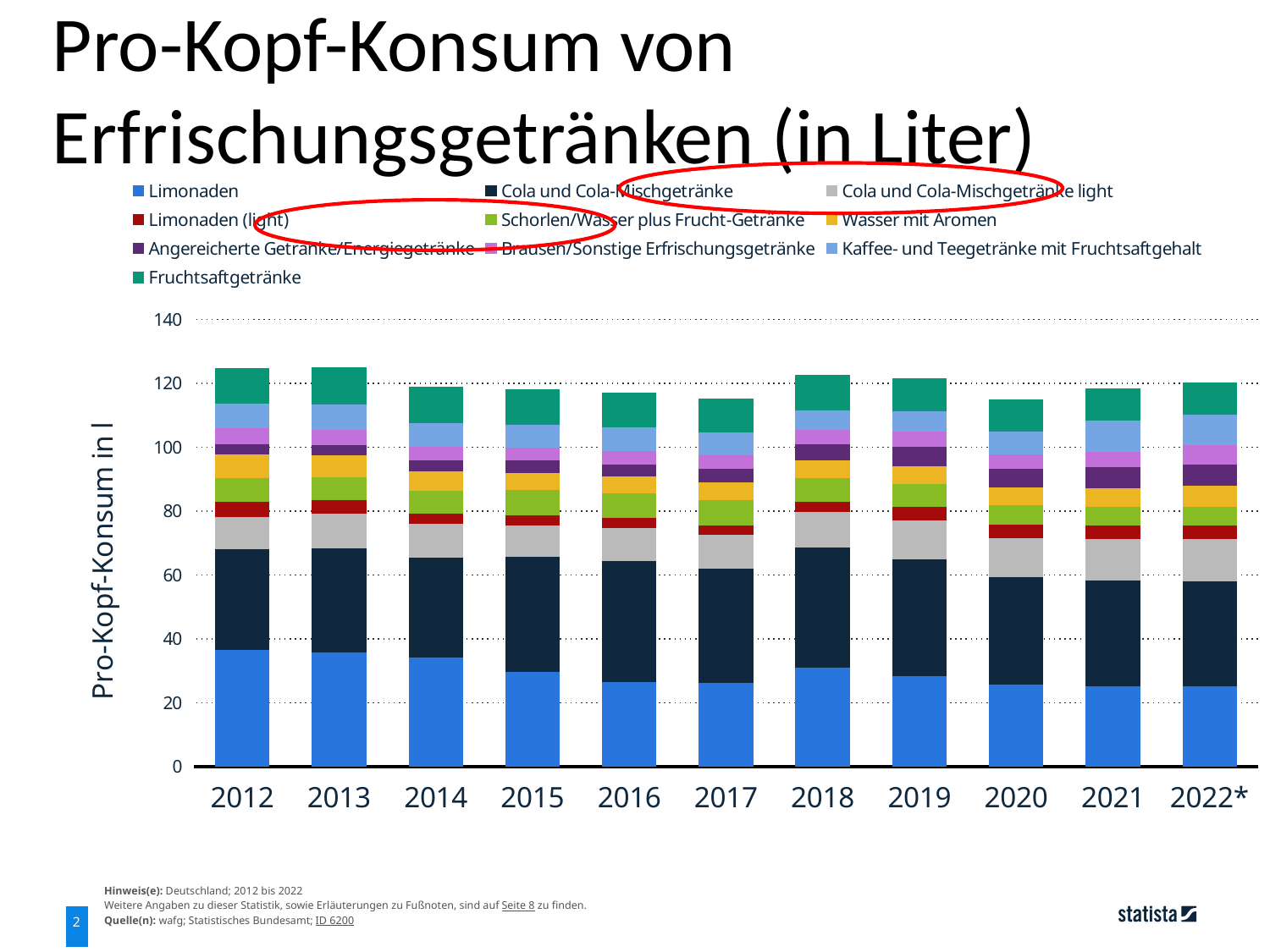
Which year has the larger total per-capita consumption, 2012 or 2020? 2012 Which year has the larger Limonaden value, 2012 or 2022*? 2012 Is the total per-capita consumption for 2012 greater or less than 120 liters? greater Is the total per-capita consumption for 2020 greater or less than 120 liters? less Is the Limonaden value for 2012 greater or less than 20 liters? greater What is the label of the y axis? Pro-Kopf-Konsum in l How many series does the legend list? 10 Which series forms the bottom segment of each stacked bar? Limonaden Does the Limonaden segment rise or fall from 2012 to 2022*? Fall How many years are shown on the x axis of the chart? 11 What kind of chart is shown on the slide? Stacked bar chart